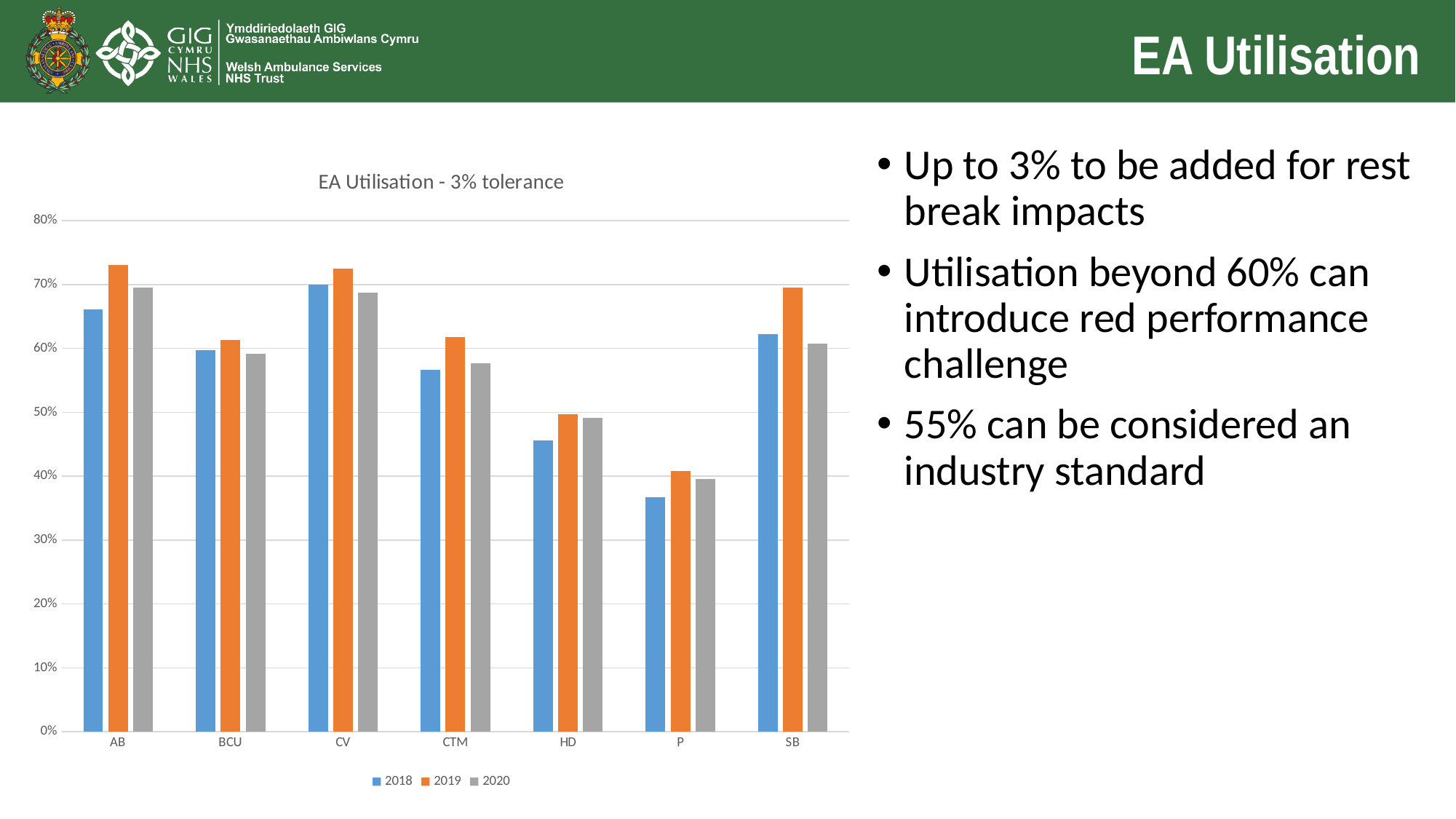
Is the value for P in 2018 greater or less than 40%? less Is the value for AB in 2019 greater or less than 70%? greater Which category has the highest value for 2018? CV Which category has the lowest value for 2019? P Which is larger, the 2020 value for CV or the 2020 value for CTM? CV What is the title of the chart? EA Utilisation - 3% tolerance How many categories are shown on the x axis of the chart? 7 Which is larger, the 2018 value for AB or the 2018 value for SB? AB How many series does the chart legend list? 3 What type of chart is shown on the slide? Bar chart Which category has the lowest value for 2020? P